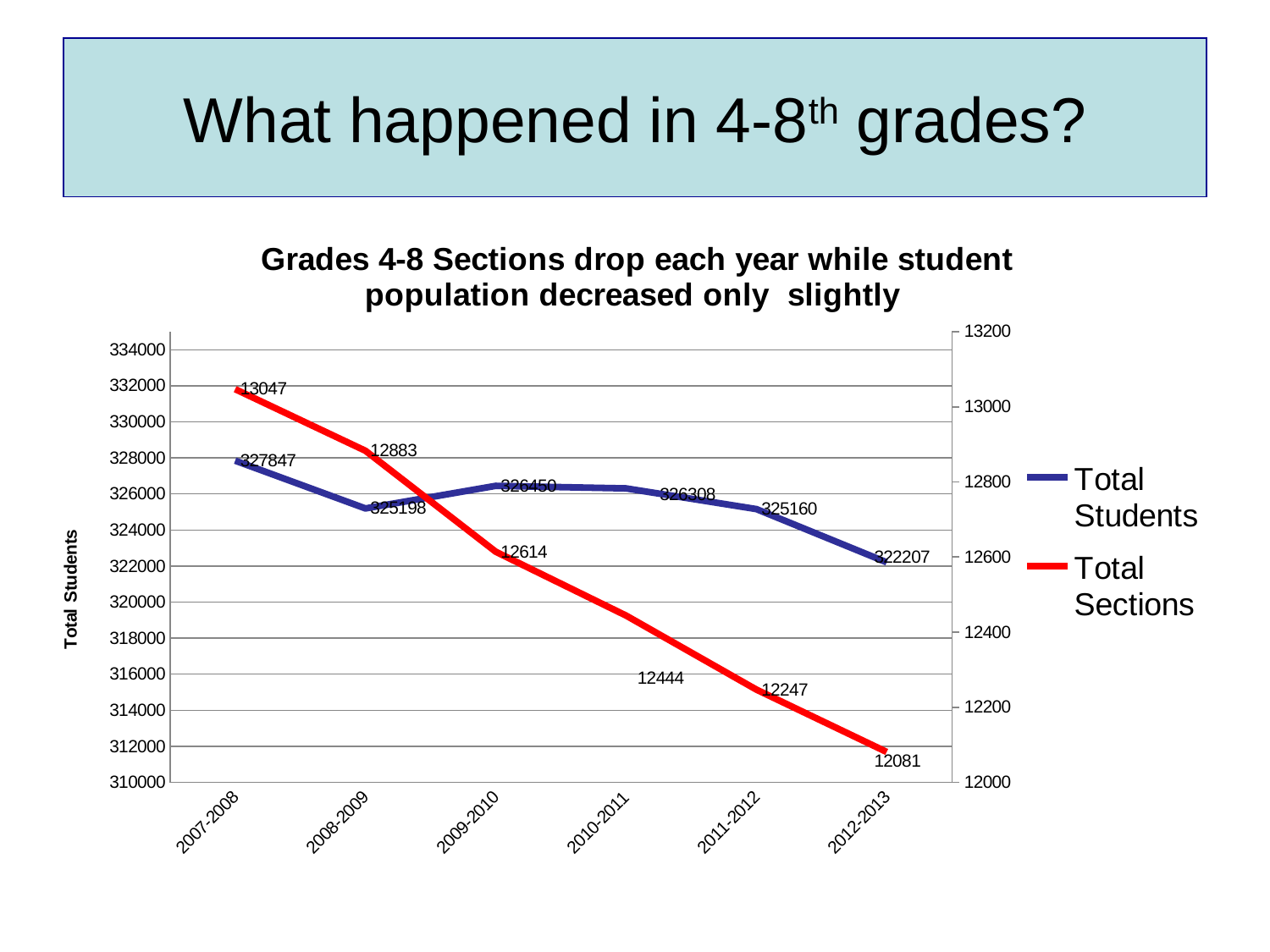
What is the Total Sections value for 2009-2010? 12614 In which school year is Total Sections highest? 2007-2008 What kind of chart is shown on the slide? Line chart What is the Total Sections value for 2012-2013? 12081 How many school years are shown on the x axis? 6 What is the difference in Total Sections between 2007-2008 and 2012-2013? 966 Which year has more Total Students, 2008-2009 or 2009-2010? 2009-2010 What is the Total Students value for 2007-2008? 327847 Does the Total Sections line rise or fall from 2007-2008 to 2012-2013? Fall In which school year is Total Students lowest? 2012-2013 What is the Total Students value for 2011-2012? 325160 How many series does the legend list? 2